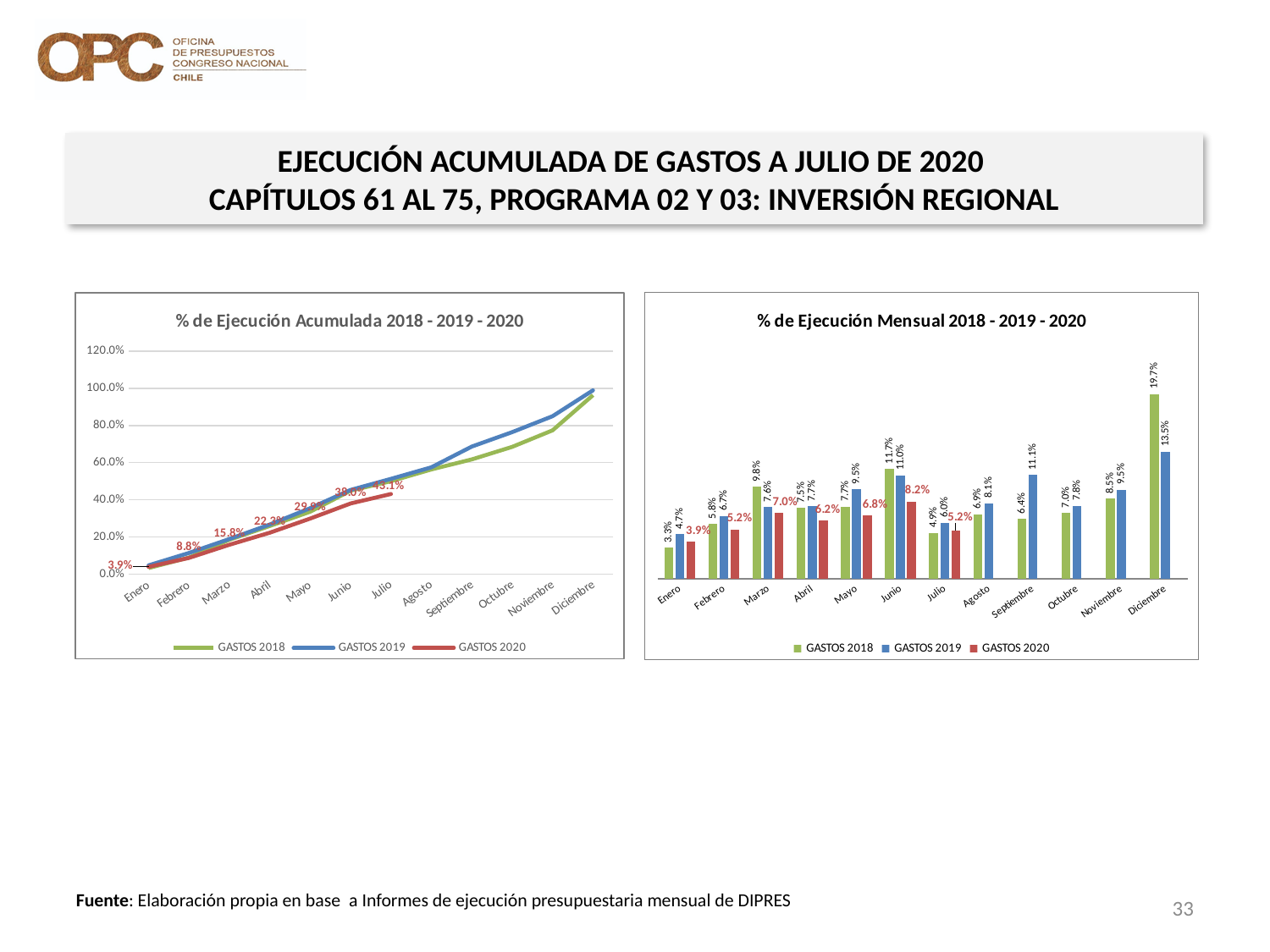
In the '% de Ejecución Mensual' chart, what is the value for GASTOS 2020 in Junio? 8.2% In the '% de Ejecución Mensual' chart, which is larger in Septiembre: GASTOS 2018 or GASTOS 2019? GASTOS 2019 In the '% de Ejecución Acumulada' chart, what is the value for GASTOS 2020 in Julio? 43.1% In the '% de Ejecución Mensual' chart, which month has the highest value for GASTOS 2018? Diciembre What kind of chart is the right-hand chart titled '% de Ejecución Mensual 2018 - 2019 - 2020'? bar chart What kind of chart is the left-hand chart titled '% de Ejecución Acumulada 2018 - 2019 - 2020'? line chart In the '% de Ejecución Acumulada' chart, is the value for GASTOS 2019 in Diciembre greater or less than 80.0%? greater In the '% de Ejecución Mensual' chart, what is the value for GASTOS 2018 in Diciembre? 19.7% In the '% de Ejecución Mensual' chart, what is the difference between GASTOS 2018 and GASTOS 2019 in Diciembre? 6.2 percentage points In the '% de Ejecución Mensual' chart, which month has the lowest value for GASTOS 2020? Enero In the '% de Ejecución Mensual' chart, how many months are shown on the x axis? 12 In the '% de Ejecución Mensual' chart, how many series does the legend list? 3